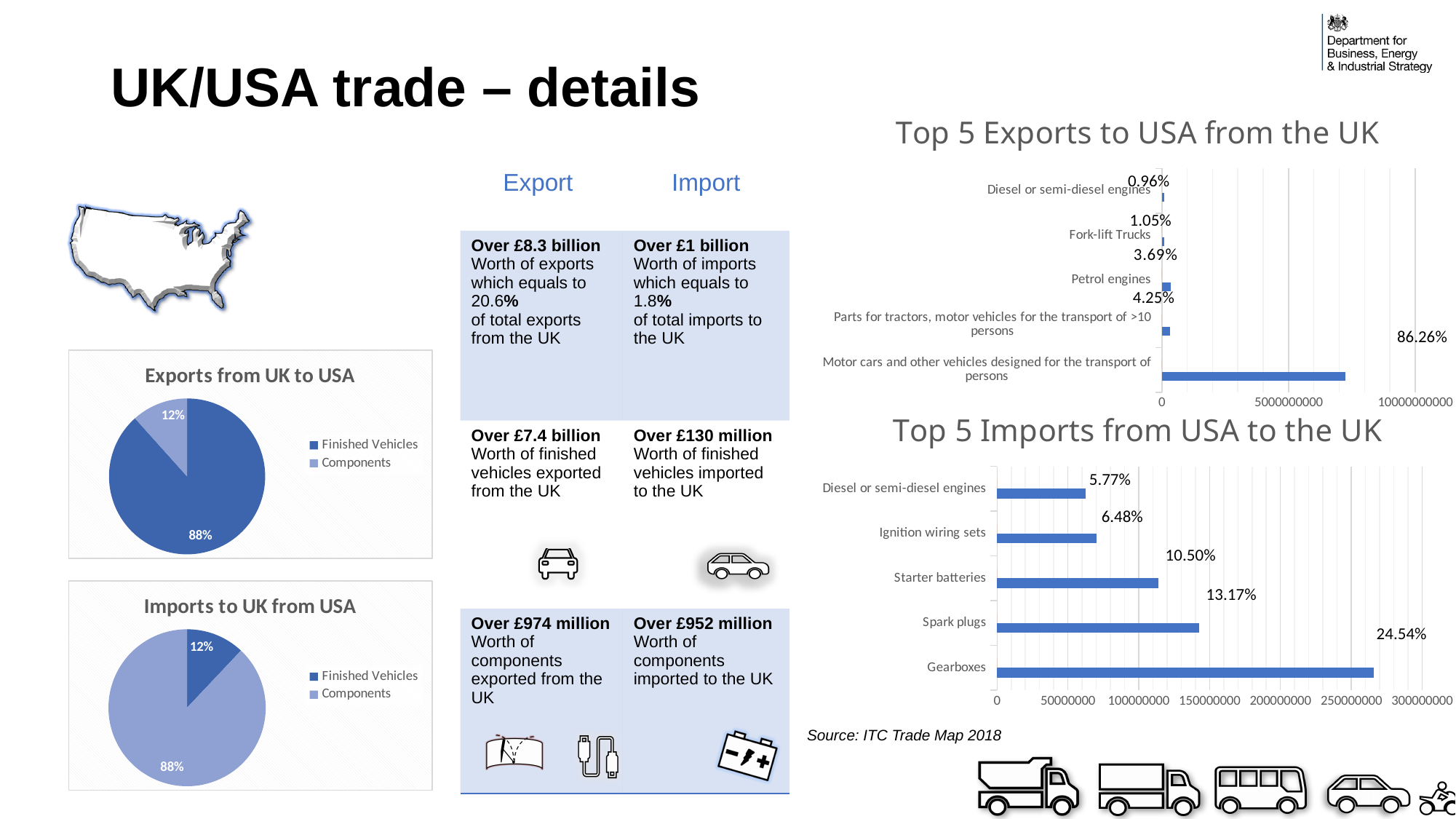
In the 'Top 5 Exports to USA from the UK' chart, which category has the lowest value? Diesel or semi-diesel engines In the 'Top 5 Imports from USA to the UK' chart, what data label is shown for Starter batteries? 10.50% In the 'Top 5 Imports from USA to the UK' chart, what is the difference between the labelled percentages for Gearboxes and Spark plugs? 11.37% In the 'Top 5 Exports to USA from the UK' chart, what data label is shown for Fork-lift Trucks? 1.05% What kind of chart is 'Top 5 Exports to USA from the UK'? Bar chart How many categories are shown in the 'Top 5 Imports from USA to the UK' chart? 5 In the 'Top 5 Exports to USA from the UK' chart, which category has the highest value? Motor cars and other vehicles designed for the transport of persons In the 'Top 5 Imports from USA to the UK' chart, is the bar for Gearboxes greater or less than 250000000? greater In the 'Top 5 Exports to USA from the UK' chart, is the bar for Motor cars and other vehicles designed for the transport of persons greater or less than 5000000000? greater In the 'Imports to UK from USA' pie chart, what share is labelled for Components? 88% In the 'Exports from UK to USA' pie chart, what share is labelled for Finished Vehicles? 88% How many entries does the legend of the 'Exports from UK to USA' pie chart list? 2